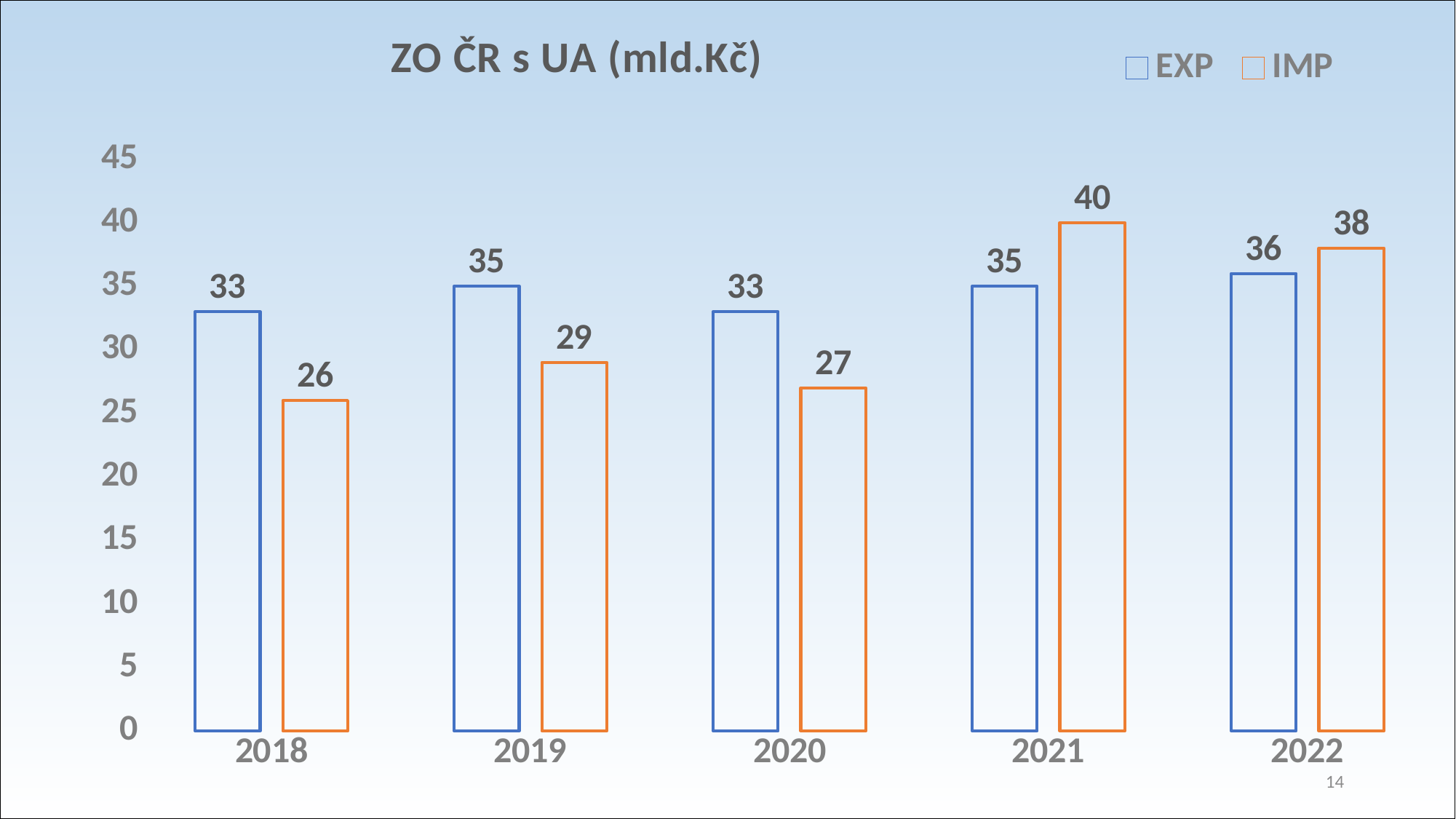
In 2020, which is larger, EXP or IMP? EXP Does the IMP value rise or fall from 2020 to 2021? rise Which year has the lowest IMP value? 2018 Which year has the highest IMP value? 2021 What is the IMP value for 2021? 40 What is the IMP value for 2018? 26 Is the IMP value for 2019 greater or less than 30? less How many years are shown on the x axis? 5 What is the difference between the IMP and EXP values in 2022? 2 What is the EXP value for 2019? 35 What kind of chart is shown? bar chart How many series does the legend list? 2